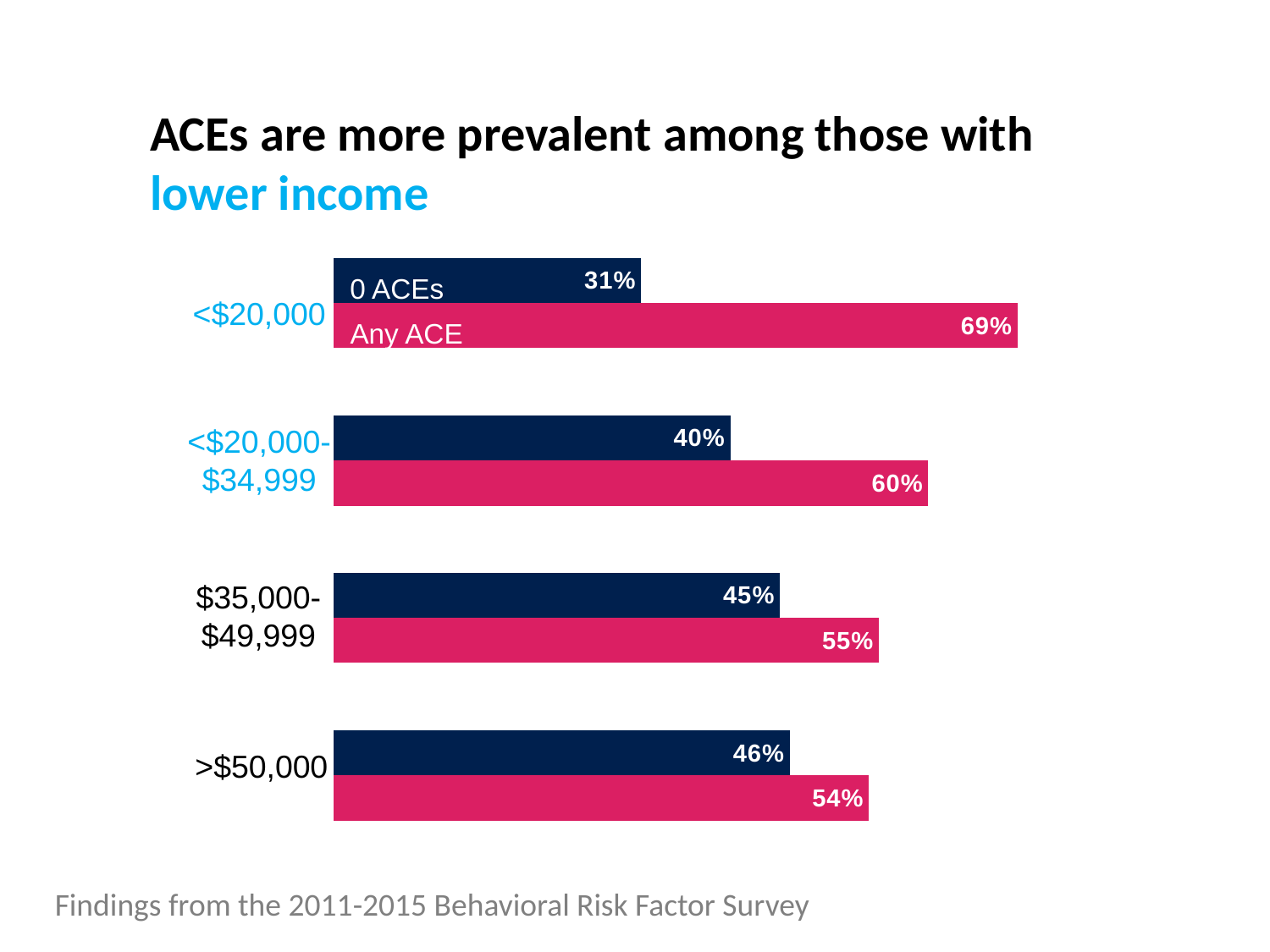
What is the difference between the Any ACE and 0 ACEs values for the <$20,000 income group? 38% What kind of chart is shown on the slide? Bar chart Which income group has the lowest 0 ACEs value? <$20,000 What is the Any ACE value for the <$20,000-$34,999 income group? 60% Which income group has the highest Any ACE value? <$20,000 How many income groups are shown in the chart? 4 How many series does the chart show? 2 What is the 0 ACEs value for the >$50,000 income group? 46% What is the 0 ACEs value for the $35,000-$49,999 income group? 45% What is the Any ACE value for the <$20,000 income group? 69% Which is larger for the >$50,000 income group: the 0 ACEs value or the Any ACE value? Any ACE What is the difference between the Any ACE values for the <$20,000 and >$50,000 income groups? 15%